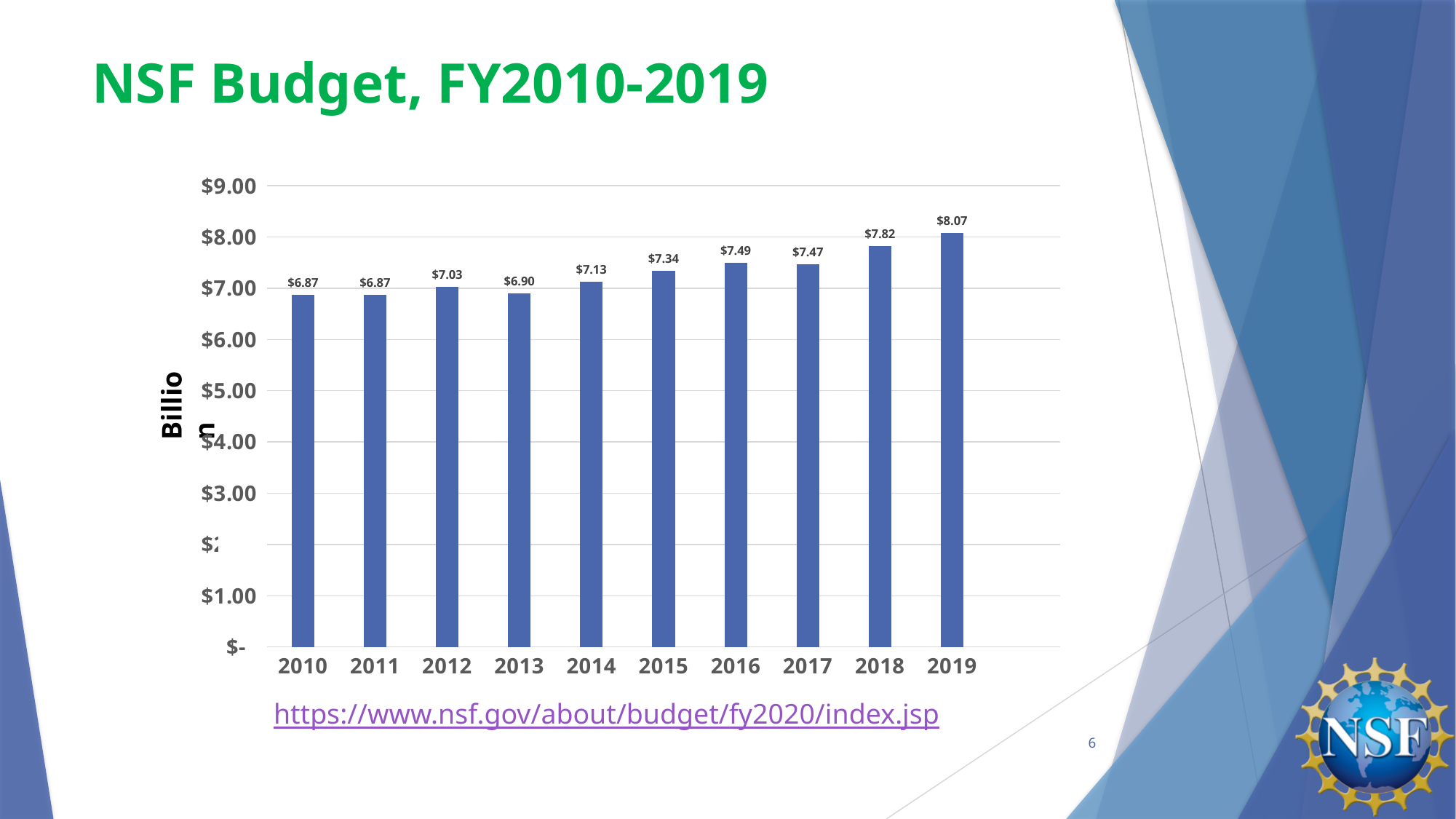
What kind of chart is shown on the slide? bar chart Which year has the highest NSF budget value? 2019 What is the NSF budget value shown for 2013? $6.90 What is the difference between the 2019 value and the 2010 value? $1.20 What is the NSF budget value shown for 2018? $7.82 How many years are plotted on the chart? 10 What is the title of the slide containing the chart? NSF Budget, FY2010-2019 What is the NSF budget value shown for 2014? $7.13 Which is larger, the value for 2016 or the value for 2017? 2016 Is the value for 2019 greater or less than $8.00? greater What is the difference between the 2017 value and the 2016 value? $0.02 Do the values generally rise or fall from 2010 to 2019? rise